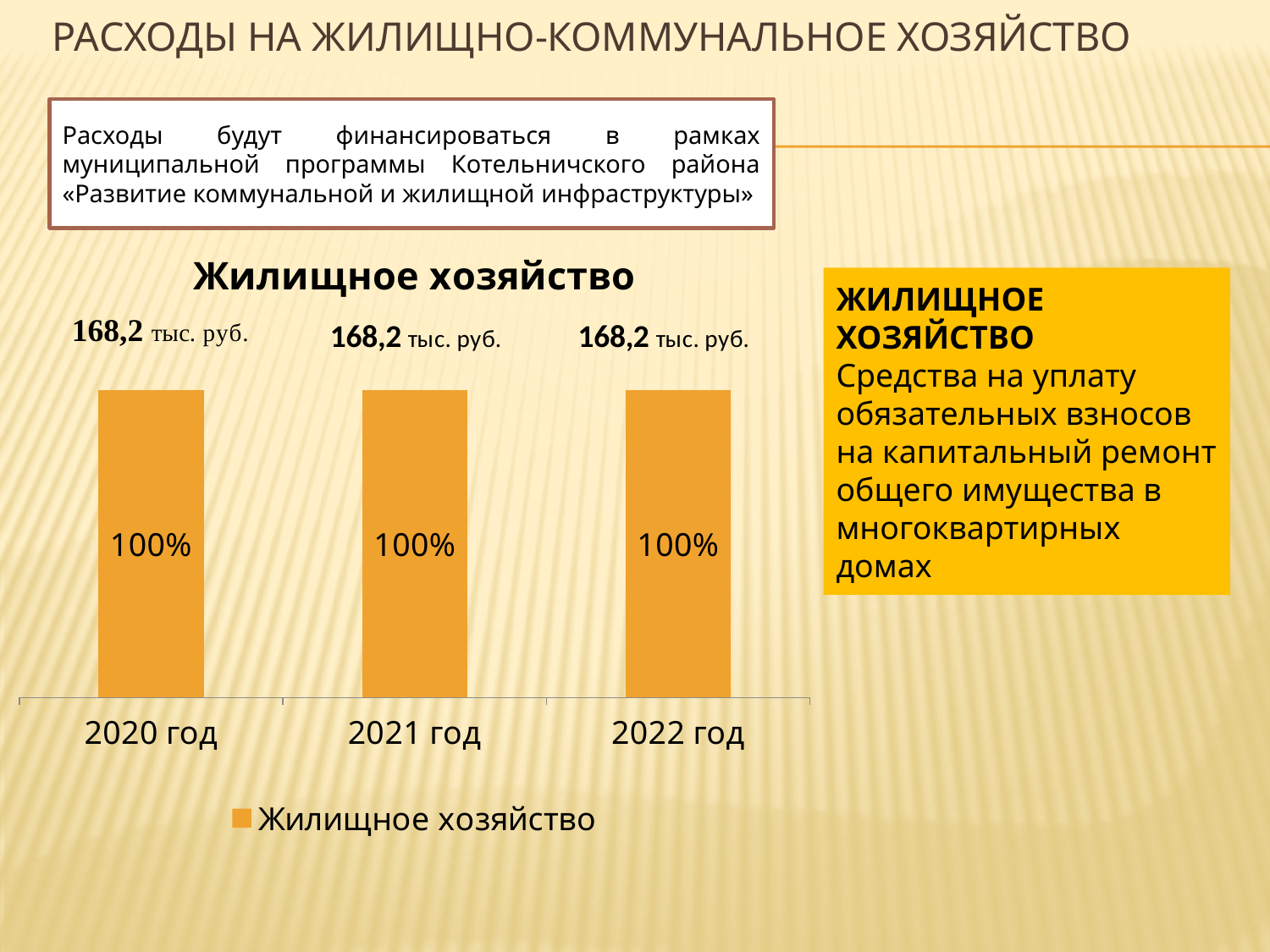
What kind of chart is shown on the slide? bar chart What is the difference between the amounts shown for 2020 год and 2022 год? 0 How many bars (categories) does the chart show? 3 What series name appears in the chart legend? Жилищное хозяйство What is the data label shown inside the bar for 2022 год? 100% What is the title of the chart? Жилищное хозяйство What amount in тыс. руб. is shown above the bar for 2021 год? 168,2 тыс. руб. What is the data label shown inside the bar for 2020 год? 100% How many series does the chart legend list? 1 Do the values rise, fall, or stay the same from 2020 год to 2022 год? stay the same What amount in тыс. руб. is shown above the bar for 2022 год? 168,2 тыс. руб.